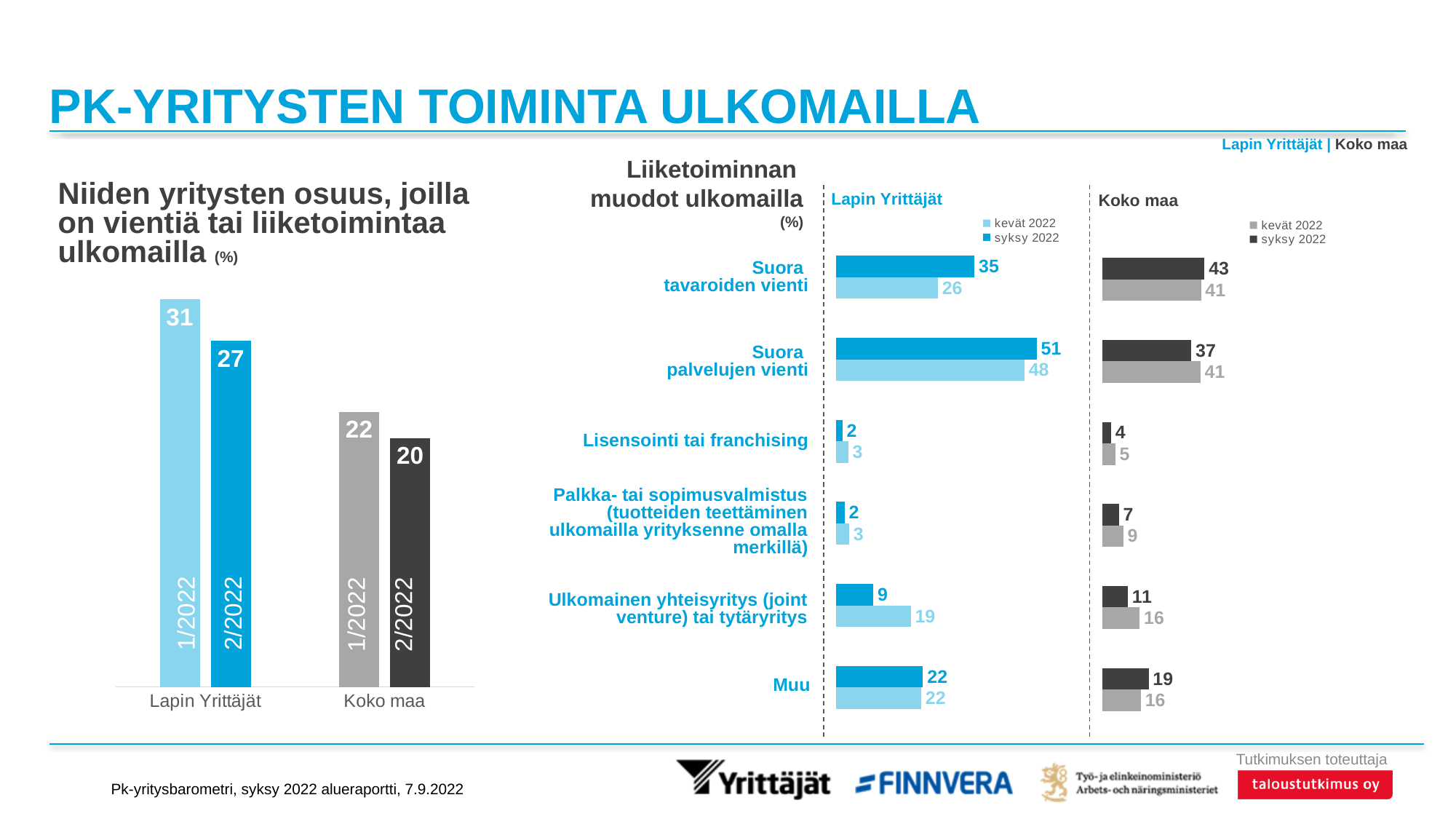
In the right chart 'Liiketoiminnan muodot ulkomailla', which is larger for Lapin Yrittäjät in Ulkomainen yhteisyritys (joint venture) tai tytäryritys: kevät 2022 or syksy 2022? kevät 2022 In the left chart 'Niiden yritysten osuus, joilla on vientiä tai liiketoimintaa ulkomailla', what is the value for Koko maa in 1/2022? 22 In the right chart 'Liiketoiminnan muodot ulkomailla', what is the syksy 2022 value for Suora palvelujen vienti for Lapin Yrittäjät? 51 In the right chart 'Liiketoiminnan muodot ulkomailla', what is the difference between the syksy 2022 and kevät 2022 values for Suora tavaroiden vienti for Lapin Yrittäjät? 9 How many series does the legend list for the Lapin Yrittäjät panel of the right chart 'Liiketoiminnan muodot ulkomailla'? 2 In the right chart 'Liiketoiminnan muodot ulkomailla', which category has the lowest syksy 2022 value for Koko maa? Lisensointi tai franchising In the left chart 'Niiden yritysten osuus, joilla on vientiä tai liiketoimintaa ulkomailla', which bar is the highest? Lapin Yrittäjät 1/2022 What kind of chart is the left chart 'Niiden yritysten osuus, joilla on vientiä tai liiketoimintaa ulkomailla'? Bar chart How many categories are listed in the right chart 'Liiketoiminnan muodot ulkomailla'? 6 In the left chart 'Niiden yritysten osuus, joilla on vientiä tai liiketoimintaa ulkomailla', what is the difference between the Lapin Yrittäjät values for 1/2022 and 2/2022? 4 In the right chart 'Liiketoiminnan muodot ulkomailla', what is the kevät 2022 value for Suora tavaroiden vienti for Koko maa? 41 In the left chart 'Niiden yritysten osuus, joilla on vientiä tai liiketoimintaa ulkomailla', what is the value for Lapin Yrittäjät in 2/2022? 27